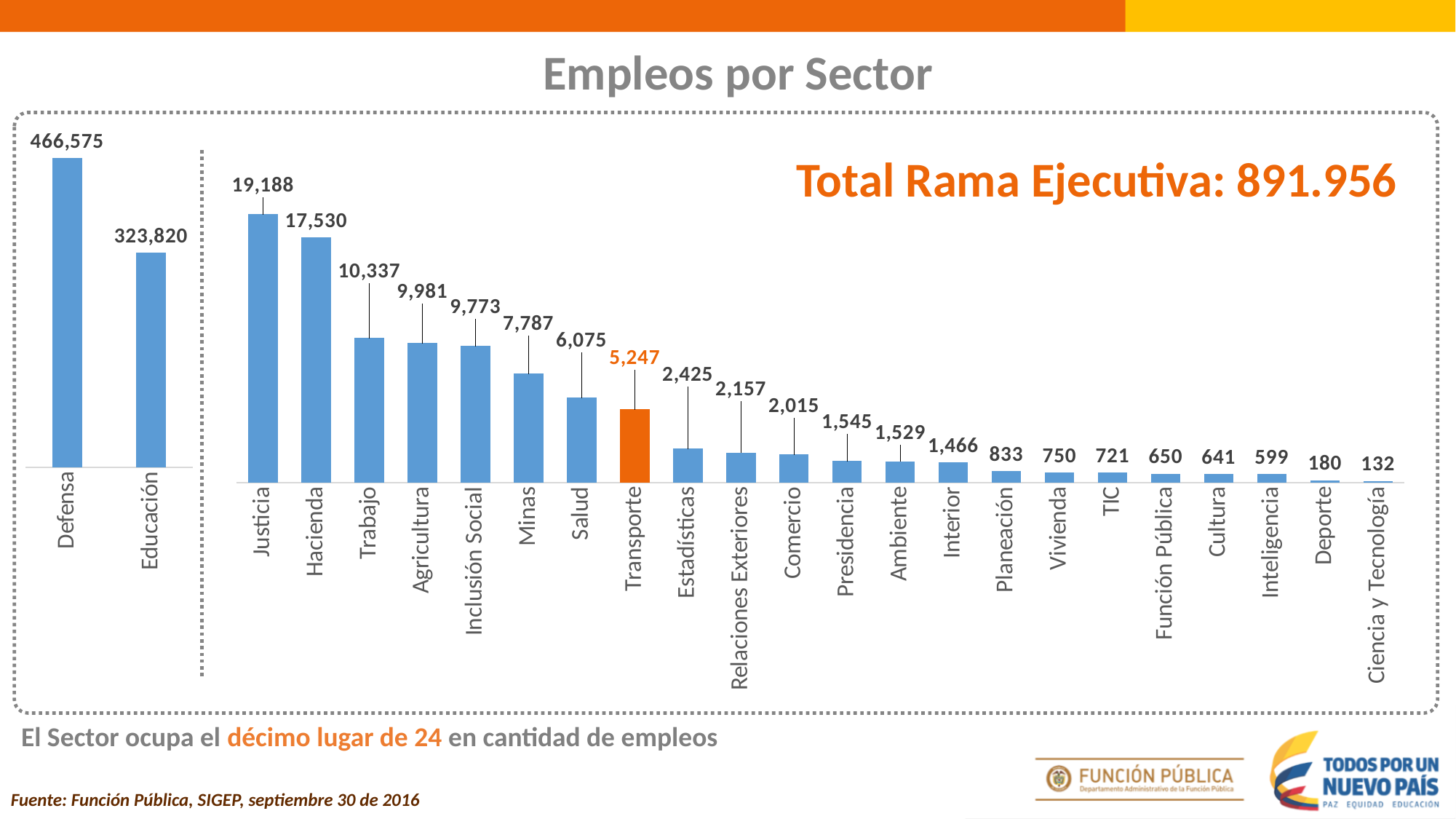
What kind of chart is used on this slide? Bar chart On the right chart, what is the difference between Justicia and Hacienda? 1,658 On the right chart, what is the value for Inclusión Social? 9,773 On the left chart, what is the value for Defensa? 466,575 On the right chart, which bar is highlighted in orange? Transporte How many sectors are shown on the right chart? 22 On the right chart, which sector has the lowest value? Ciencia y Tecnología On the right chart, which is larger, Salud or Minas? Minas On the left chart, what is the difference between Defensa and Educación? 142,755 On the left chart, what is the value for Educación? 323,820 On the right chart, which sector has the highest value? Justicia On the right chart, what is the value for Transporte? 5,247